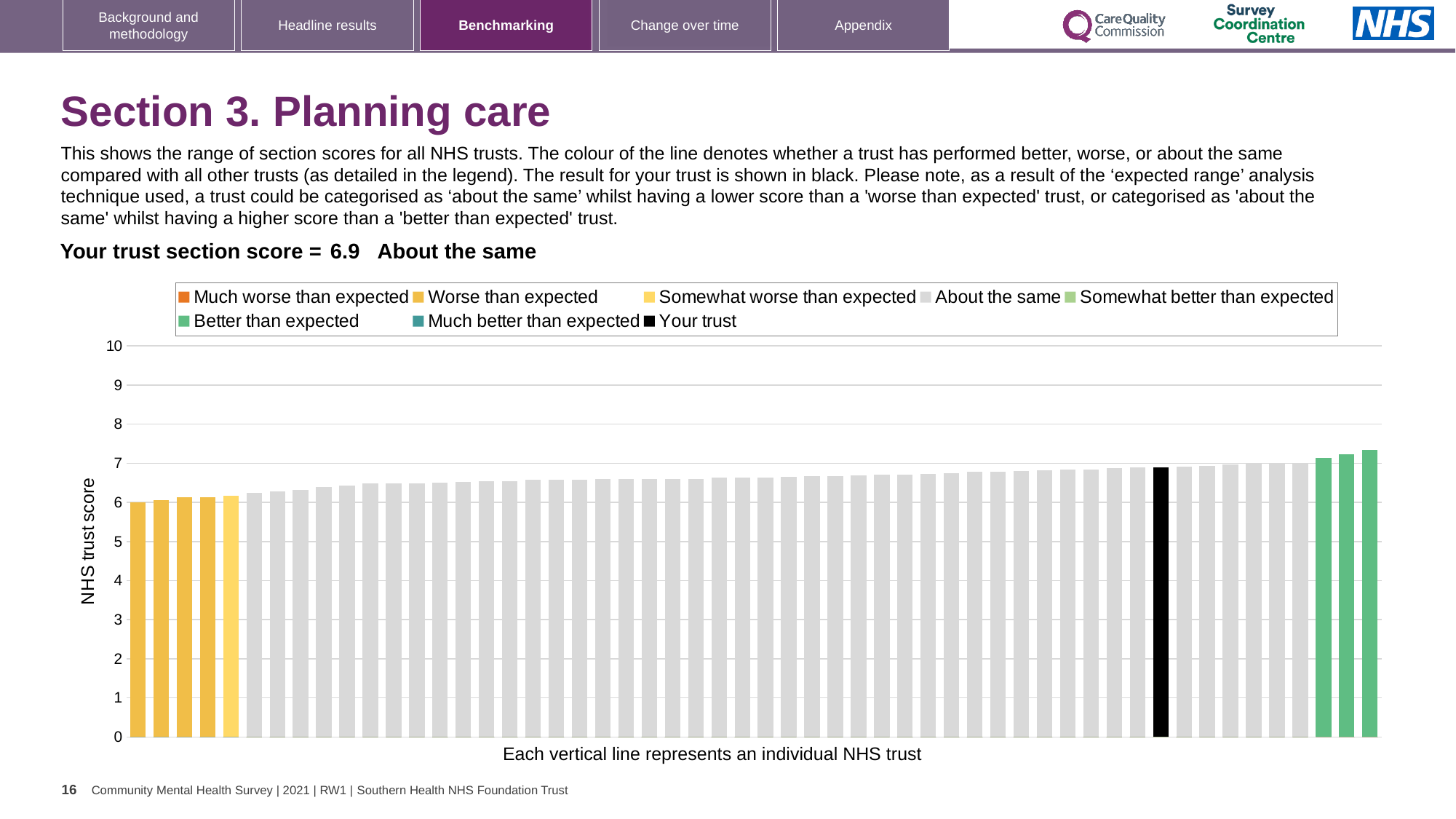
How many entries does the chart legend list? 8 Is the value of the lowest bar greater or less than 5? greater What is the section score for your trust shown on the slide? 6.9 Is your trust's bar higher or lower than the rightmost bar in the chart? Lower Which category is your trust placed in for this section? About the same What colour is used for the bar representing your trust? Black What kind of chart is shown on the slide? Bar chart Do the bar values rise or fall from left to right along the x axis? Rise What is the label on the vertical axis of the chart? NHS trust score How many bars are coloured green (better than expected)? 3 Is the value for your trust greater or less than 6? greater Is the value of the highest bar greater or less than 8? less